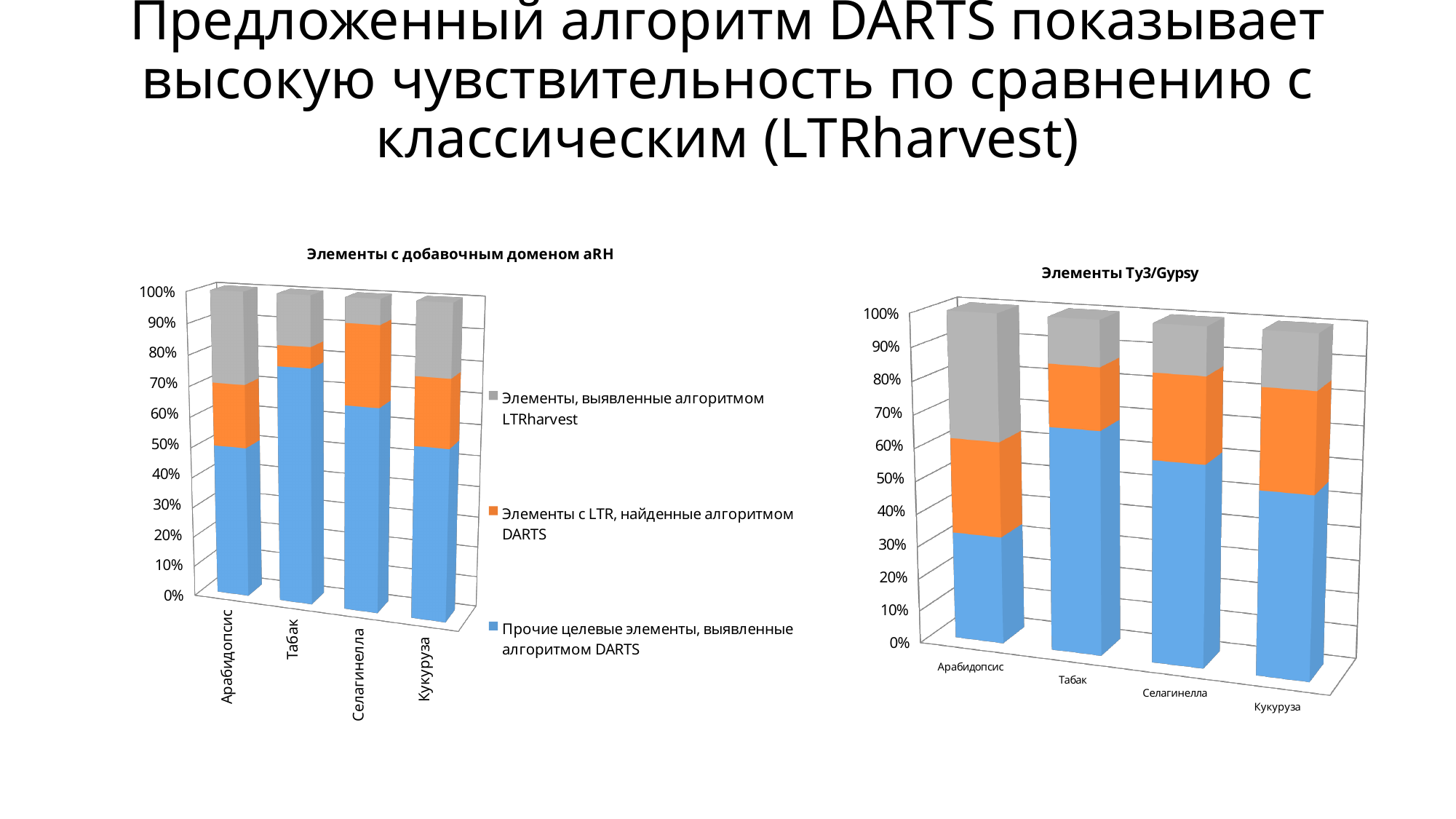
What kind of chart is the chart titled "Элементы с добавочным доменом aRH"? Stacked bar chart What is the title of the chart on the right side of the slide? Элементы Ty3/Gypsy In the legend, which series is shown in orange? Элементы с LTR, найденные алгоритмом DARTS How many categories are shown on the x axis of the chart titled "Элементы Ty3/Gypsy"? 4 How many series does the legend on the slide list? 3 In the chart titled "Элементы Ty3/Gypsy", which has the larger blue segment, Селагинелла or Кукуруза? Селагинелла In the chart titled "Элементы с добавочным доменом aRH", is the blue segment for Табак greater or less than 70%? greater In the chart titled "Элементы с добавочным доменом aRH", which category has the smallest grey segment (Элементы, выявленные алгоритмом LTRharvest)? Селагинелла In the chart titled "Элементы Ty3/Gypsy", which category has the largest grey segment (Элементы, выявленные алгоритмом LTRharvest)? Арабидопсис In the chart titled "Элементы с добавочным доменом aRH", which category has the largest blue segment (Прочие целевые элементы, выявленные алгоритмом DARTS)? Табак In the chart titled "Элементы Ty3/Gypsy", which category has the smallest blue segment (Прочие целевые элементы, выявленные алгоритмом DARTS)? Арабидопсис In the chart titled "Элементы Ty3/Gypsy", is the blue segment for Арабидопсис greater or less than 40%? less